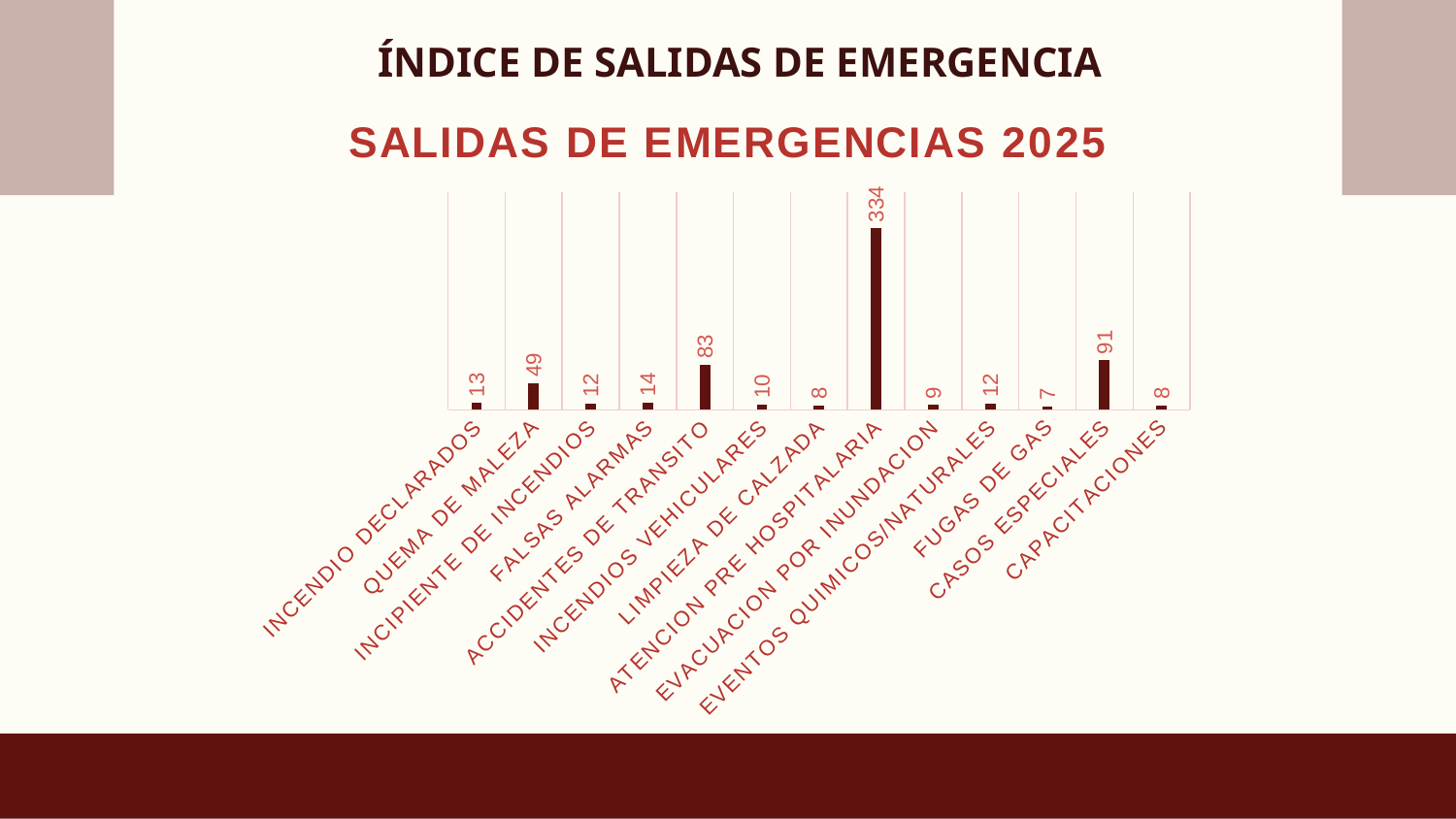
Which is larger, the value for CASOS ESPECIALES or the value for ACCIDENTES DE TRANSITO? CASOS ESPECIALES What kind of chart is shown on the slide? Bar chart What is the value for CASOS ESPECIALES? 91 What is the value for ACCIDENTES DE TRANSITO? 83 What is the difference between the values for ATENCION PRE HOSPITALARIA and CASOS ESPECIALES? 243 What is the value for ATENCION PRE HOSPITALARIA? 334 What is the difference between the values for ACCIDENTES DE TRANSITO and QUEMA DE MALEZA? 34 What is the value for QUEMA DE MALEZA? 49 Which category has the lowest value? FUGAS DE GAS How many categories are shown on the x axis? 13 Which category has the highest value? ATENCION PRE HOSPITALARIA What is the value for FUGAS DE GAS? 7